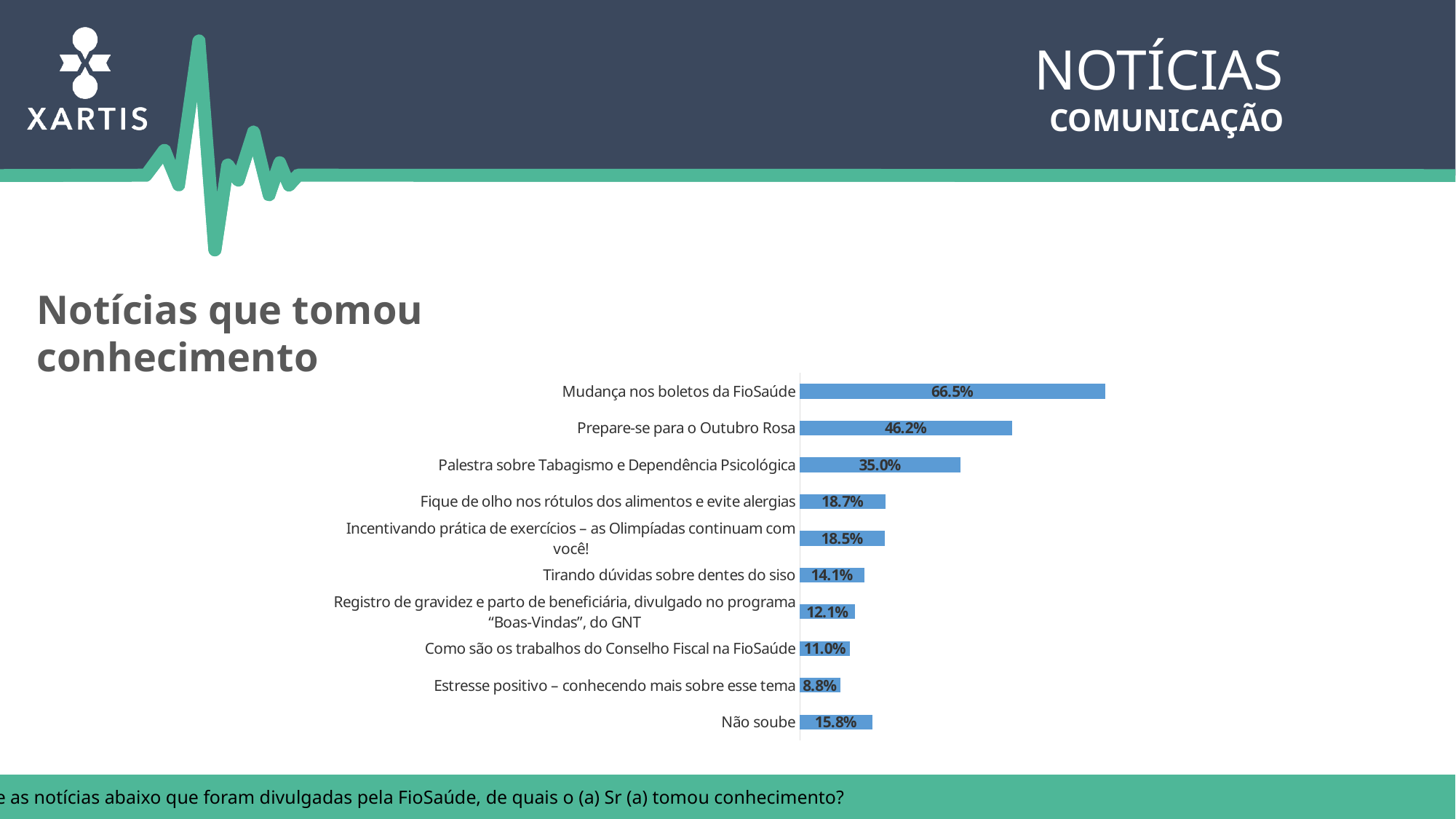
What is the value for "Tirando dúvidas sobre dentes do siso"? 14.1% What is the difference between "Mudança nos boletos da FioSaúde" and "Prepare-se para o Outubro Rosa"? 20.3% What is the value for "Não soube"? 15.8% How many categories are shown in the chart? 10 What is the value for "Prepare-se para o Outubro Rosa"? 46.2% Which is larger: "Como são os trabalhos do Conselho Fiscal na FioSaúde" or "Registro de gravidez e parto de beneficiária, divulgado no programa “Boas-Vindas”, do GNT"? Registro de gravidez e parto de beneficiária, divulgado no programa “Boas-Vindas”, do GNT Which category has the lowest value? Estresse positivo – conhecendo mais sobre esse tema What is the value for "Mudança nos boletos da FioSaúde"? 66.5% What is the difference between "Palestra sobre Tabagismo e Dependência Psicológica" and "Não soube"? 19.2% What kind of chart is shown on the slide? Bar chart What is the title of the chart on the slide? Notícias que tomou conhecimento Which category has the highest value? Mudança nos boletos da FioSaúde